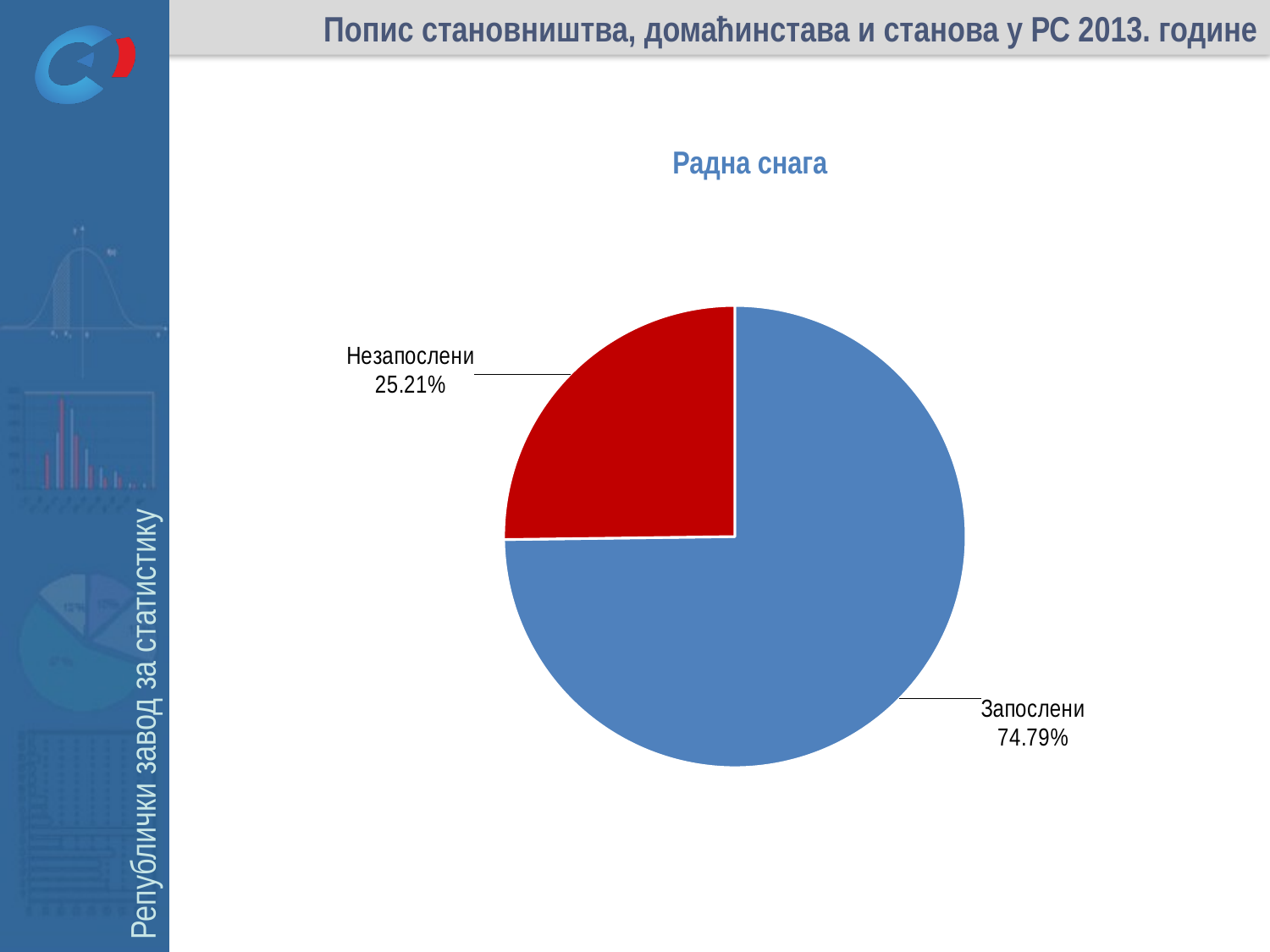
Which slice of the pie is the largest? Запослени Which is larger, the share for Запослени or the share for Незапослени? Запослени Which slice of the pie is the smallest? Незапослени What share of the pie is labelled Незапослени? 25.21% What type of chart is shown on the slide? pie chart How many slices does the pie chart have? 2 What colour is the Незапослени slice? red What share of the pie is labelled Запослени? 74.79% What is the title of the chart? Радна снага What is the difference in percentage points between the Запослени and Незапослени shares? 49.58